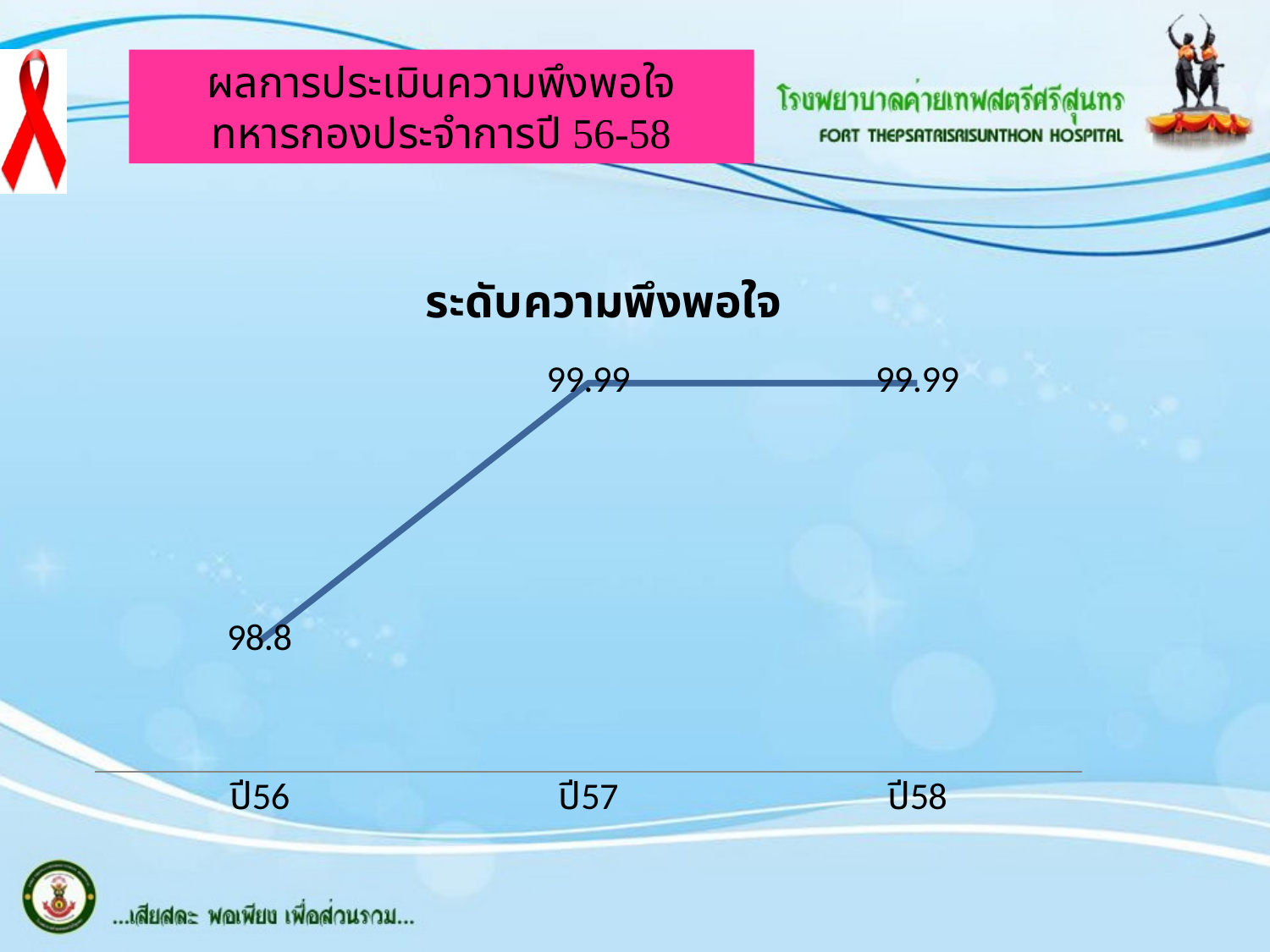
What is the title of the chart? ระดับความพึงพอใจ How does the value change from ปี57 to ปี58? It stays the same How does the value change from ปี56 to ปี57? It rises Which year has the lowest satisfaction value? ปี56 What is the difference between the values for ปี57 and ปี56? 1.19 Do the values for ปี57 and ปี58 differ? No, both are 99.99 Which is larger, the value for ปี56 or the value for ปี58? ปี58 What is the satisfaction value for ปี56? 98.8 What is the satisfaction value for ปี57? 99.99 What kind of chart is shown on the slide? line chart How many years are plotted on the chart? 3 What is the satisfaction value for ปี58? 99.99